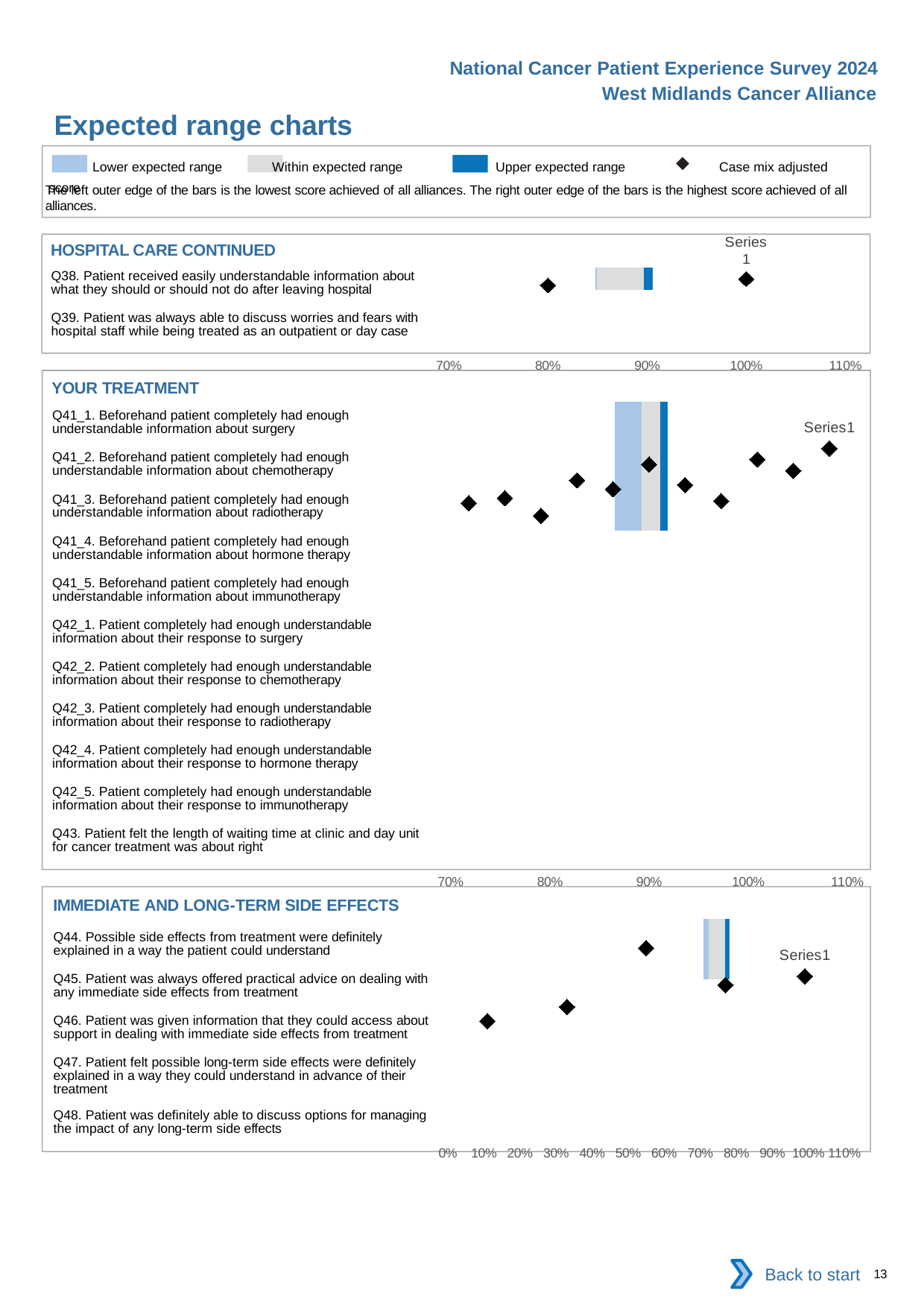
In the HOSPITAL CARE CONTINUED chart, is the rightmost plotted marker greater or less than 90%? greater In the YOUR TREATMENT chart, what is the lowest value shown on the x axis? 70% In the HOSPITAL CARE CONTINUED chart, is the leftmost plotted marker greater or less than 90%? less In the IMMEDIATE AND LONG-TERM SIDE EFFECTS chart, is the leftmost plotted marker greater or less than 20%? less How many data point markers are plotted in the IMMEDIATE AND LONG-TERM SIDE EFFECTS chart? 5 In the IMMEDIATE AND LONG-TERM SIDE EFFECTS chart, what is the lowest value shown on the x axis? 0% How many data point markers are plotted in the HOSPITAL CARE CONTINUED chart? 2 How many series does the legend of the YOUR TREATMENT chart list? 1 How many data point markers are plotted in the YOUR TREATMENT chart? 11